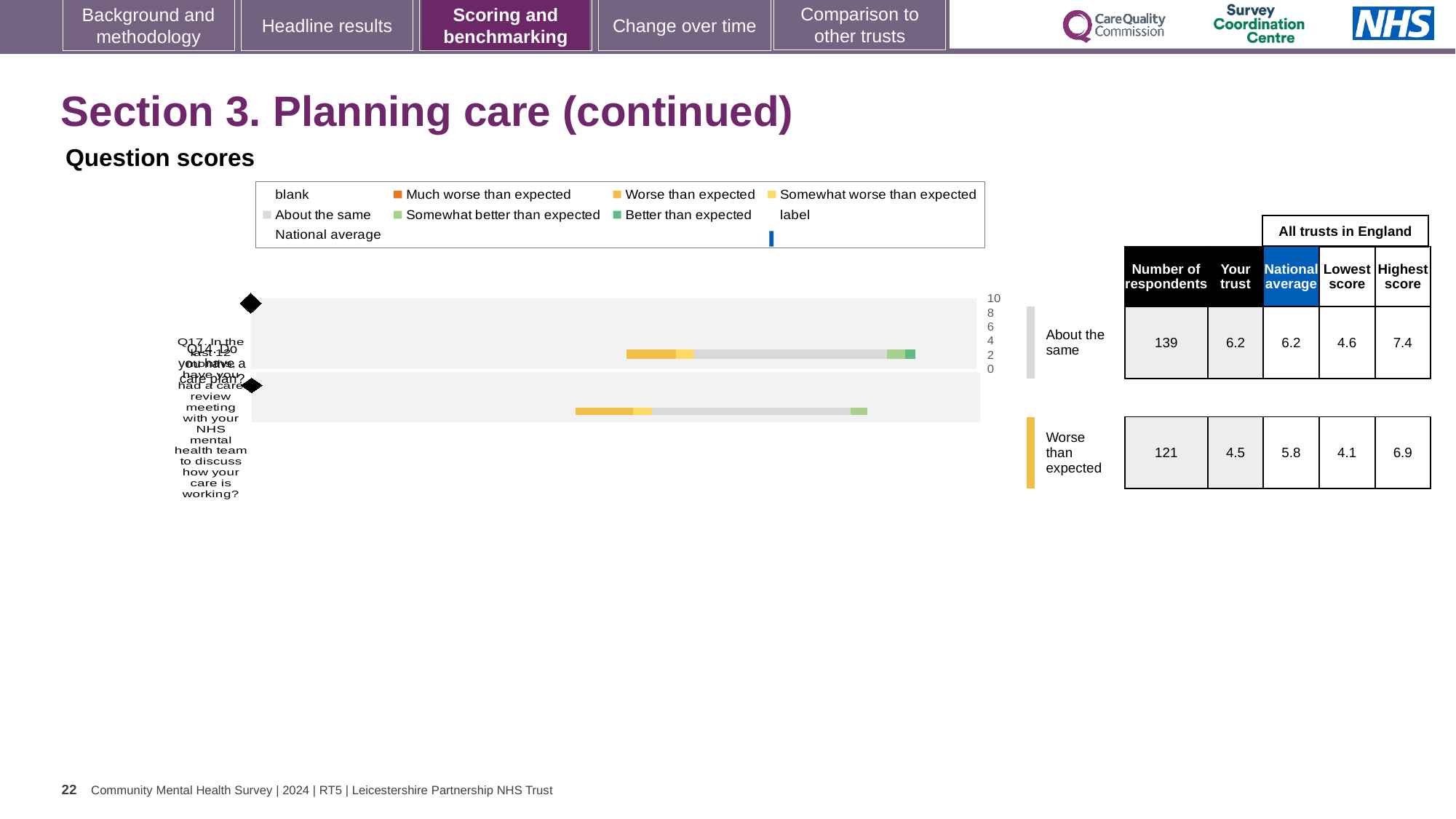
What kind of chart is shown under 'Question scores'? bar chart What is the highest score across all trusts in England for the row rated 'About the same'? 7.4 What is the difference between the national average and the 'Your trust' score for the row rated 'Worse than expected'? 1.3 How many question rows (bars) are plotted in the chart? 2 What is the national average for the row rated 'Worse than expected'? 5.8 What is the 'Your trust' score for the bottom row, rated 'Worse than expected'? 4.5 What is the maximum value shown on the chart's score axis? 10 Which row has the higher 'Your trust' score, the one rated 'About the same' or the one rated 'Worse than expected'? About the same What is the lowest score across all trusts in England for the row rated 'Worse than expected'? 4.1 How many respondents answered the question in the row rated 'About the same'? 139 What is the 'Your trust' score for the top row, rated 'About the same'? 6.2